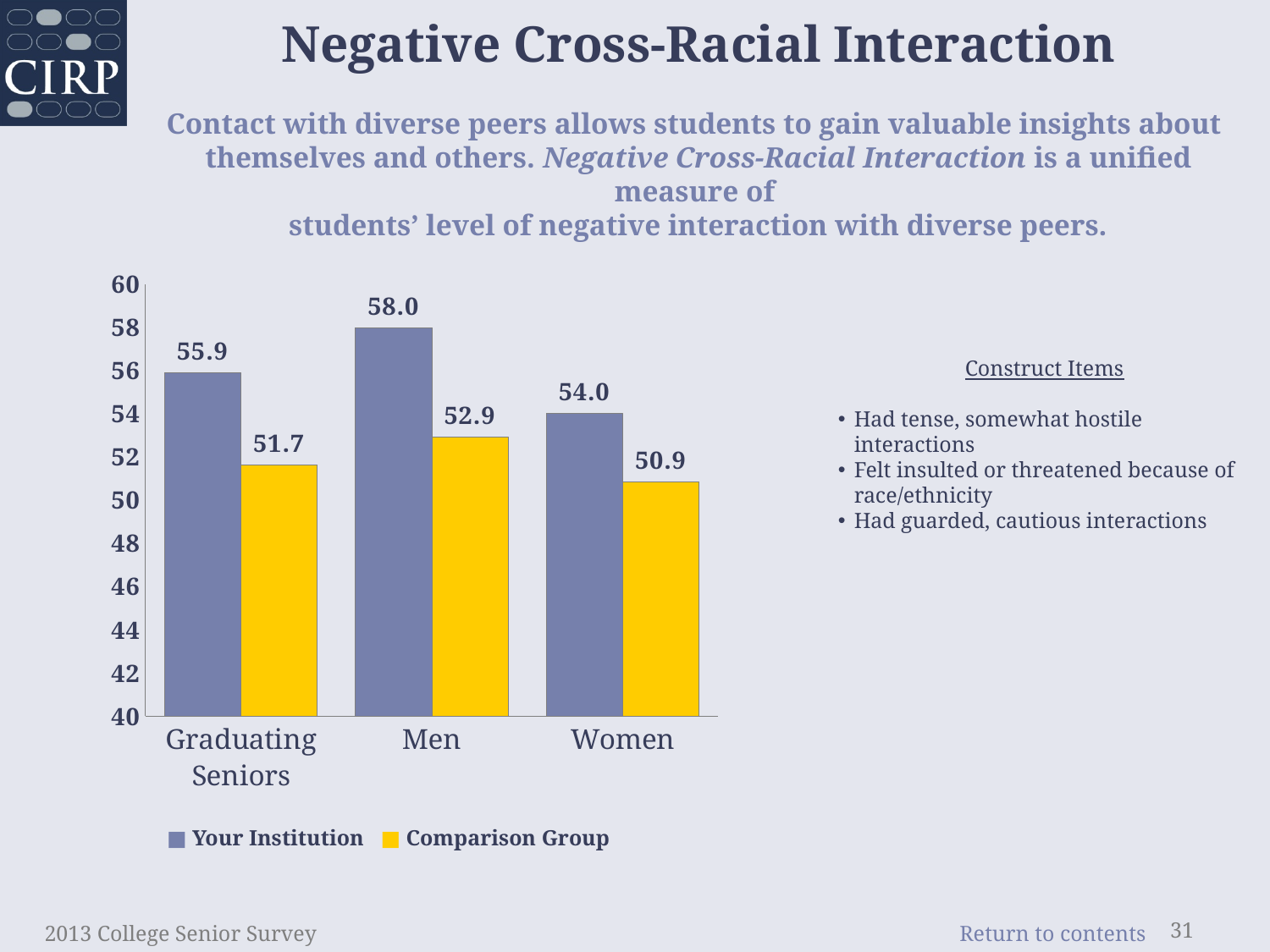
What is the value for Your Institution for Men? 58.0 What kind of chart is shown on the slide? Bar chart Which is larger for Women: Your Institution or the Comparison Group? Your Institution How many series does the legend list? 2 Which category has the lowest value for the Comparison Group? Women What is the difference between Your Institution and the Comparison Group for Graduating Seniors? 4.2 What is the value for the Comparison Group for Women? 50.9 Is the value for the Comparison Group for Graduating Seniors greater or less than 52? less What is the value for Your Institution for Graduating Seniors? 55.9 What is the difference between Your Institution and the Comparison Group for Men? 5.1 Which category has the highest value for Your Institution? Men How many categories are shown on the x axis? 3